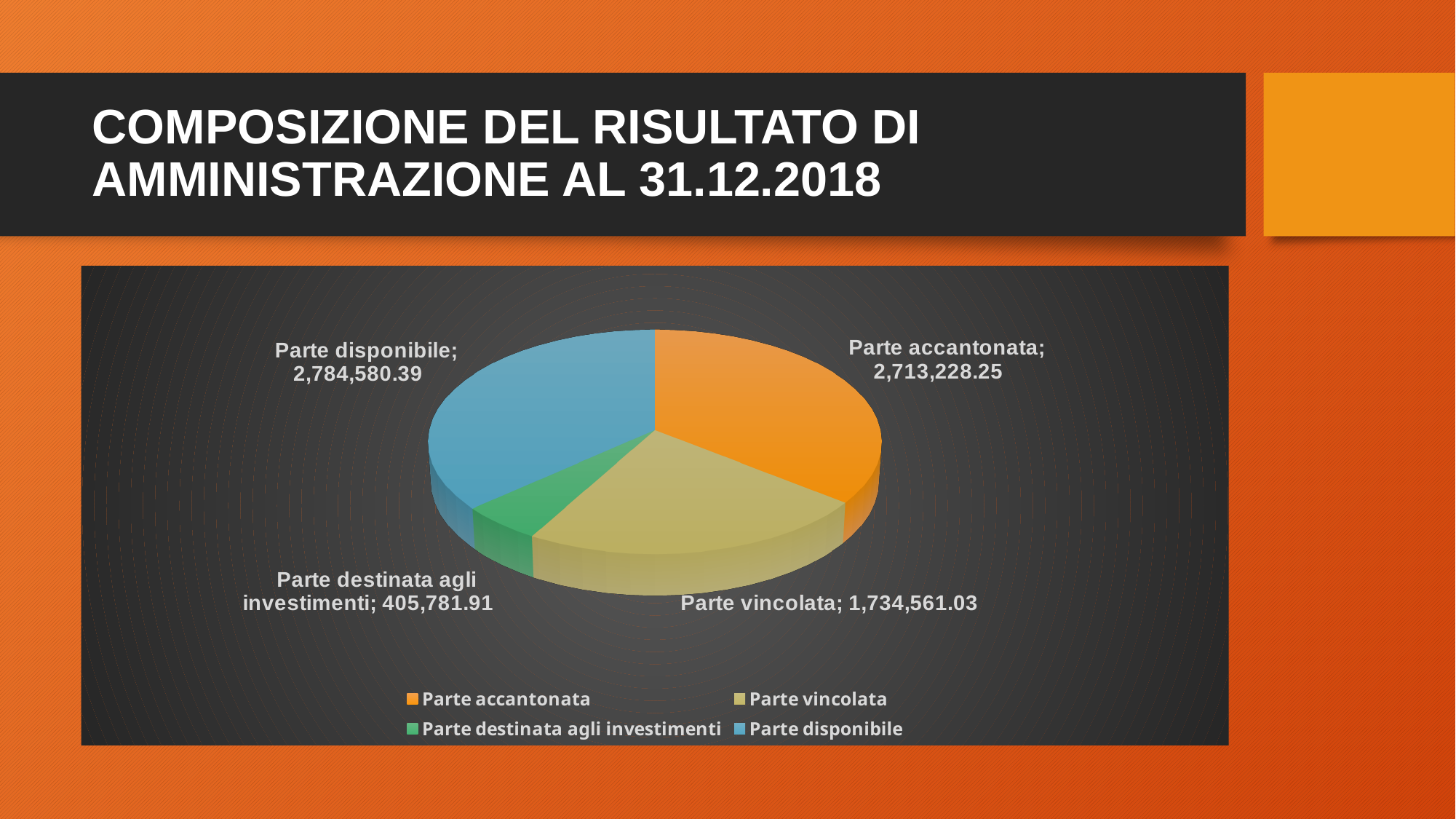
What is the value of the Parte accantonata slice? 2,713,228.25 What type of chart is shown on the slide? Pie chart Which slice of the pie has the largest value? Parte disponibile What colour is the Parte vincolata slice in the pie chart? Yellow (tan) How many slices does the pie chart have? 4 What is the difference between the Parte disponibile value and the Parte accantonata value? 71,352.14 What is the value of the Parte destinata agli investimenti slice? 405,781.91 Which is larger, Parte vincolata or Parte destinata agli investimenti? Parte vincolata What is the value of the Parte disponibile slice? 2,784,580.39 Which slice of the pie has the smallest value? Parte destinata agli investimenti What is the value of the Parte vincolata slice? 1,734,561.03 What is the total of all four slices in the pie chart? 7,638,151.58